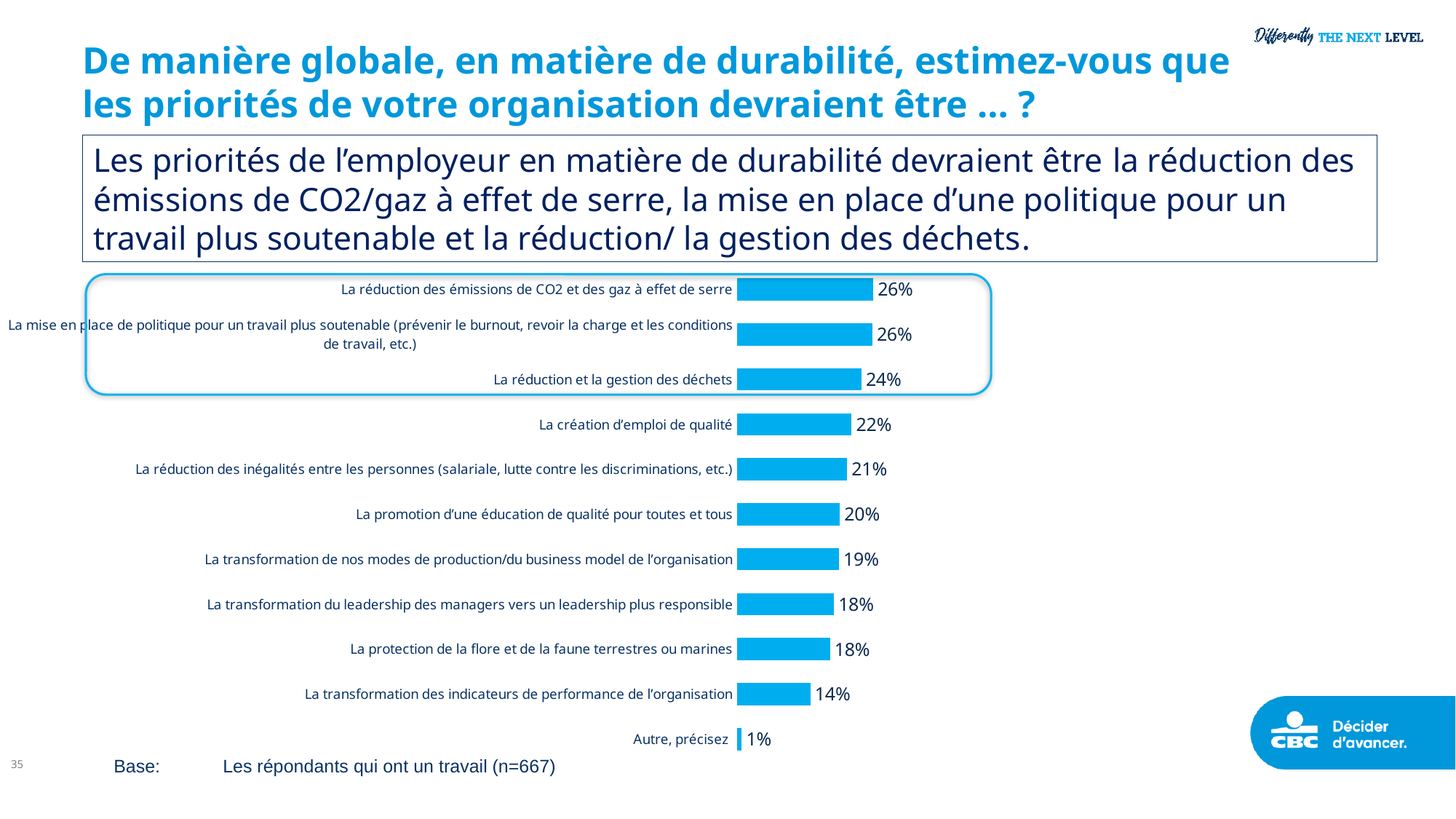
What kind of chart is shown on the slide? Bar chart How many categories are enclosed in the highlighted rounded box at the top of the chart? 3 What is the difference in percentage points between 'La promotion d'une éducation de qualité pour toutes et tous' and 'La transformation des indicateurs de performance de l'organisation'? 6 percentage points Which category has the lowest value in the chart? Autre, précisez How many categories are shown in the chart? 11 What percentage of respondents chose 'La réduction et la gestion des déchets'? 24% Which two categories share the same value of 18%? La transformation du leadership des managers vers un leadership plus responsible; La protection de la flore et de la faune terrestres ou marines What is the difference in percentage points between 'La réduction des émissions de CO2 et des gaz à effet de serre' and 'La réduction et la gestion des déchets'? 2 percentage points What is the value shown for 'La création d'emploi de qualité'? 22% Which is larger: the value for 'La réduction des inégalités entre les personnes' or the value for 'La protection de la flore et de la faune terrestres ou marines'? La réduction des inégalités entre les personnes What value is shown for 'La réduction des émissions de CO2 et des gaz à effet de serre'? 26% What percentage is shown for 'La transformation des indicateurs de performance de l'organisation'? 14%